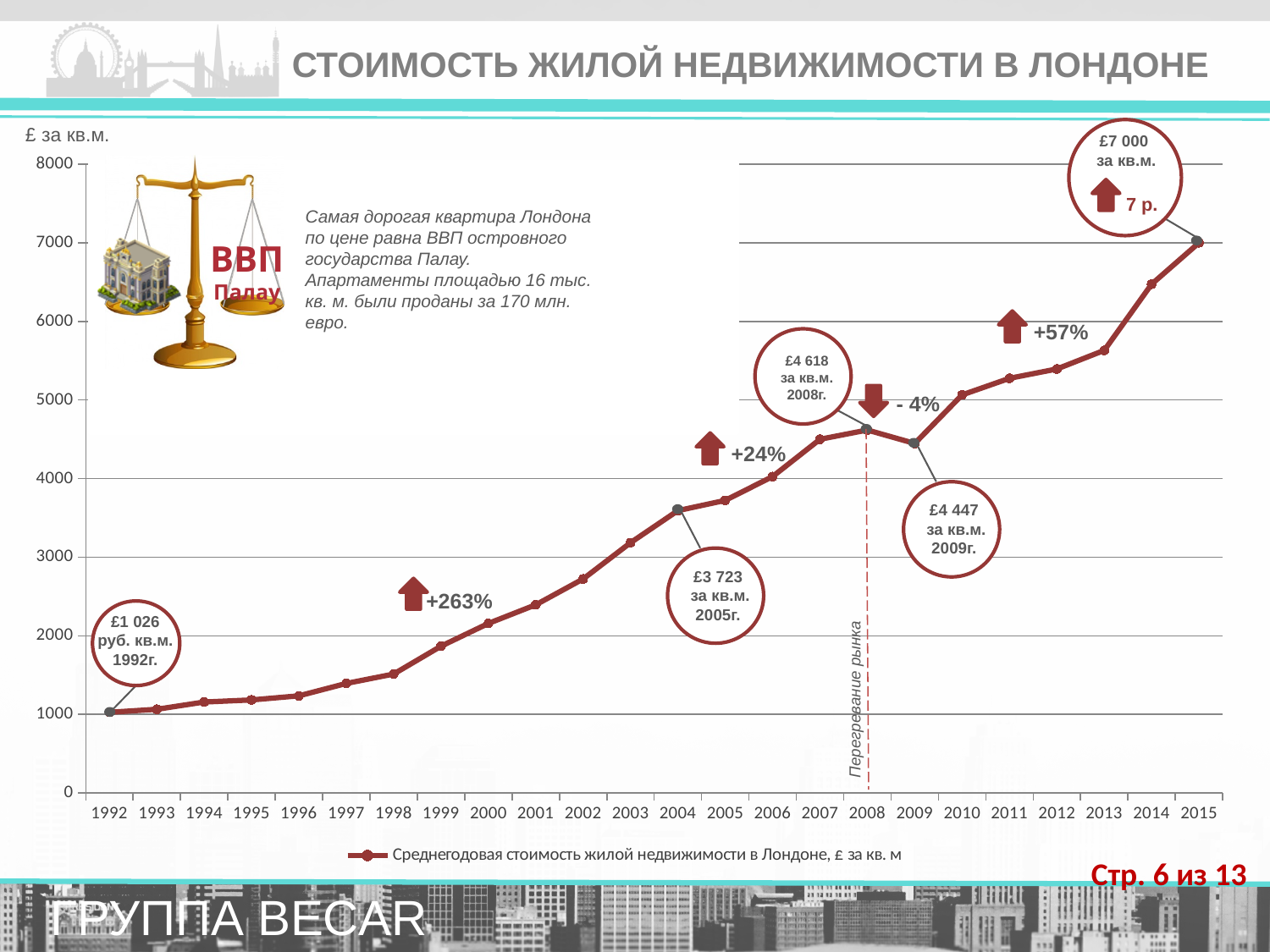
What value does the callout give for 2009? £4 447 за кв.м. What value does the callout give for 2005? £3 723 за кв.м. Which year has the lowest value on the chart? 1992 What was the average price per sq. m in London in 1992, according to the callout? £1 026 Which year has the highest value on the chart? 2015 What value does the callout give for 2015? £7 000 за кв.м. What label is written next to the vertical dashed line at 2008? Перегревание рынка What type of chart is shown on the slide? Line chart Is the value for 2013 greater or less than 5000? greater By how much did the value fall from 2008 to 2009, based on the callout values? £171 How many years are plotted on the x axis? 24 What value does the callout give for 2008? £4 618 за кв.м.